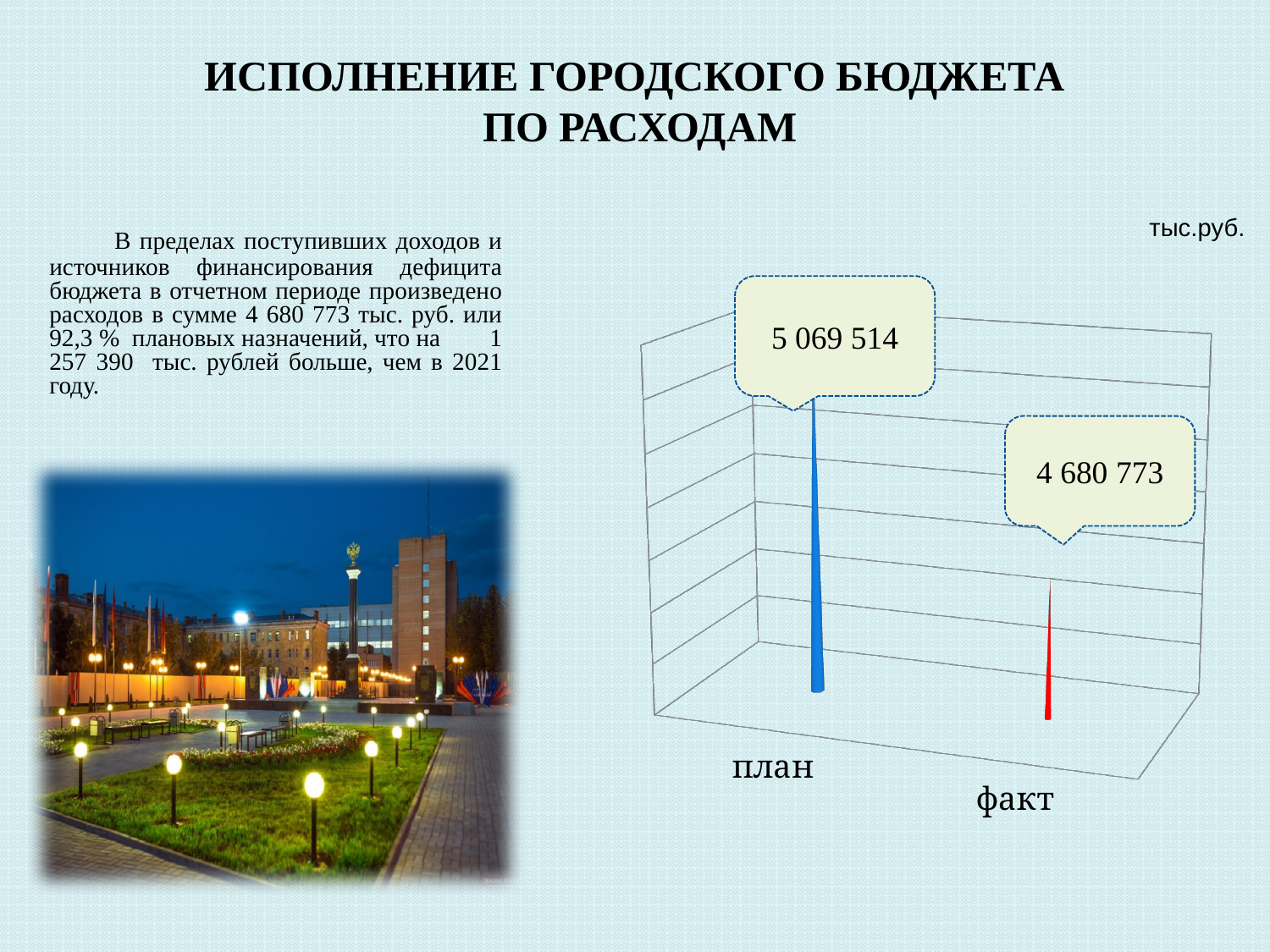
What is the value shown for план on the chart? 5 069 514 Which category has the higher value, план or факт? план Which category has the lowest value on the chart? факт What colour is the bar for факт? red How many categories are plotted on the chart? 2 Which category has the highest value on the chart? план What kind of chart is shown on the slide? bar chart What is the difference between the план and факт values? 388 741 Do the values fall or rise from план to факт? fall What is the value shown for факт on the chart? 4 680 773 What unit is indicated for the chart values? тыс.руб.